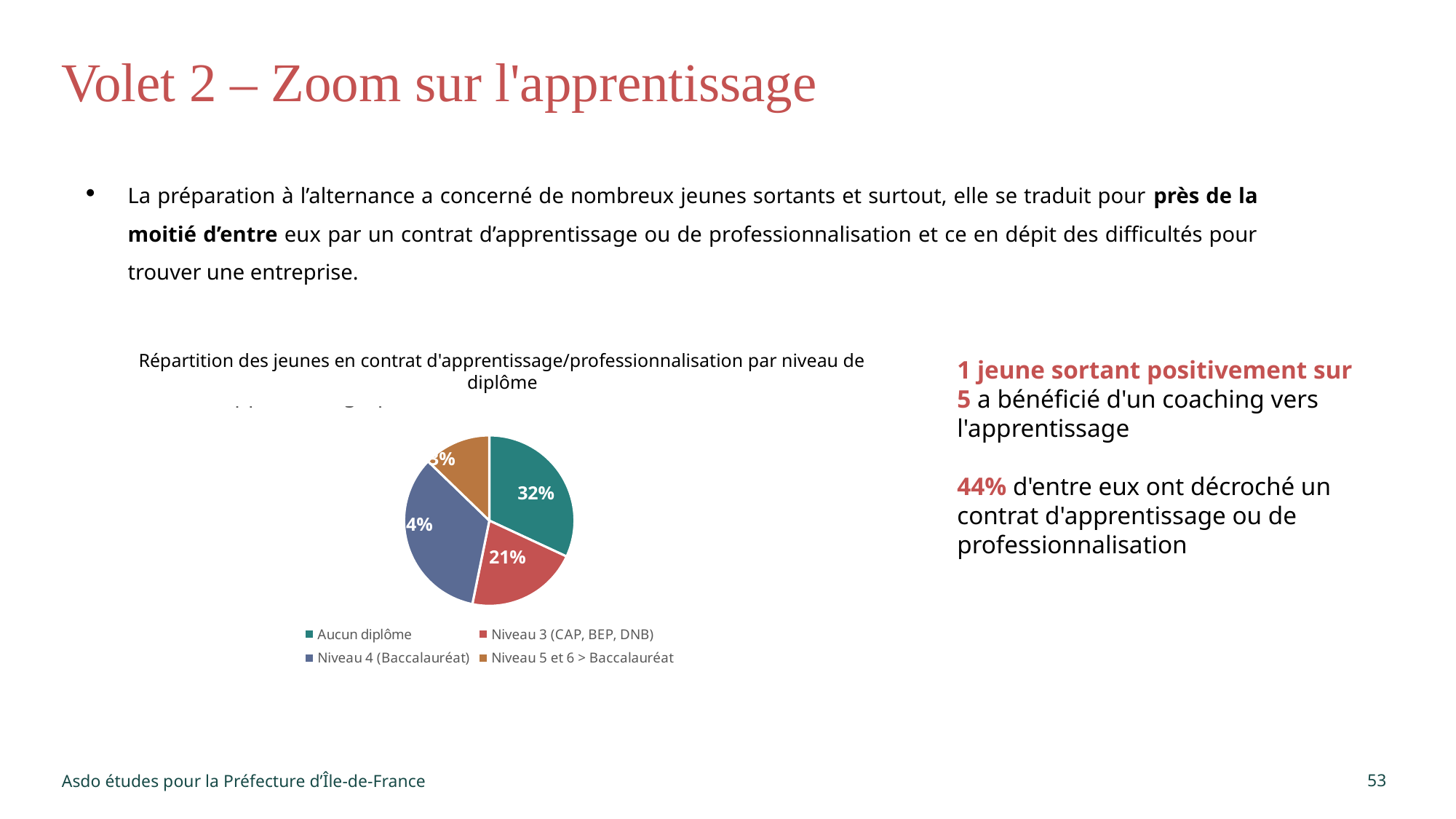
Which colour represents 'Aucun diplôme' in the pie chart? Teal (green) Which category has the smallest slice in the pie chart? Niveau 5 et 6 > Baccalauréat How many entries does the legend of the pie chart list? 4 Which slice is larger in the pie chart: 'Aucun diplôme' or 'Niveau 3 (CAP, BEP, DNB)'? Aucun diplôme Which slice is larger in the pie chart: 'Niveau 4 (Baccalauréat)' or 'Niveau 5 et 6 > Baccalauréat'? Niveau 4 (Baccalauréat) How many categories are shown in the pie chart? 4 What kind of chart is shown on the slide? Pie chart What share of the pie chart is labelled for 'Niveau 3 (CAP, BEP, DNB)'? 21% What share of the pie chart is labelled for 'Aucun diplôme'? 32% What is the title of the chart on the slide? Répartition des jeunes en contrat d'apprentissage/professionnalisation par niveau de diplôme By how many percentage points does the 'Aucun diplôme' slice exceed the 'Niveau 3 (CAP, BEP, DNB)' slice? 11 percentage points